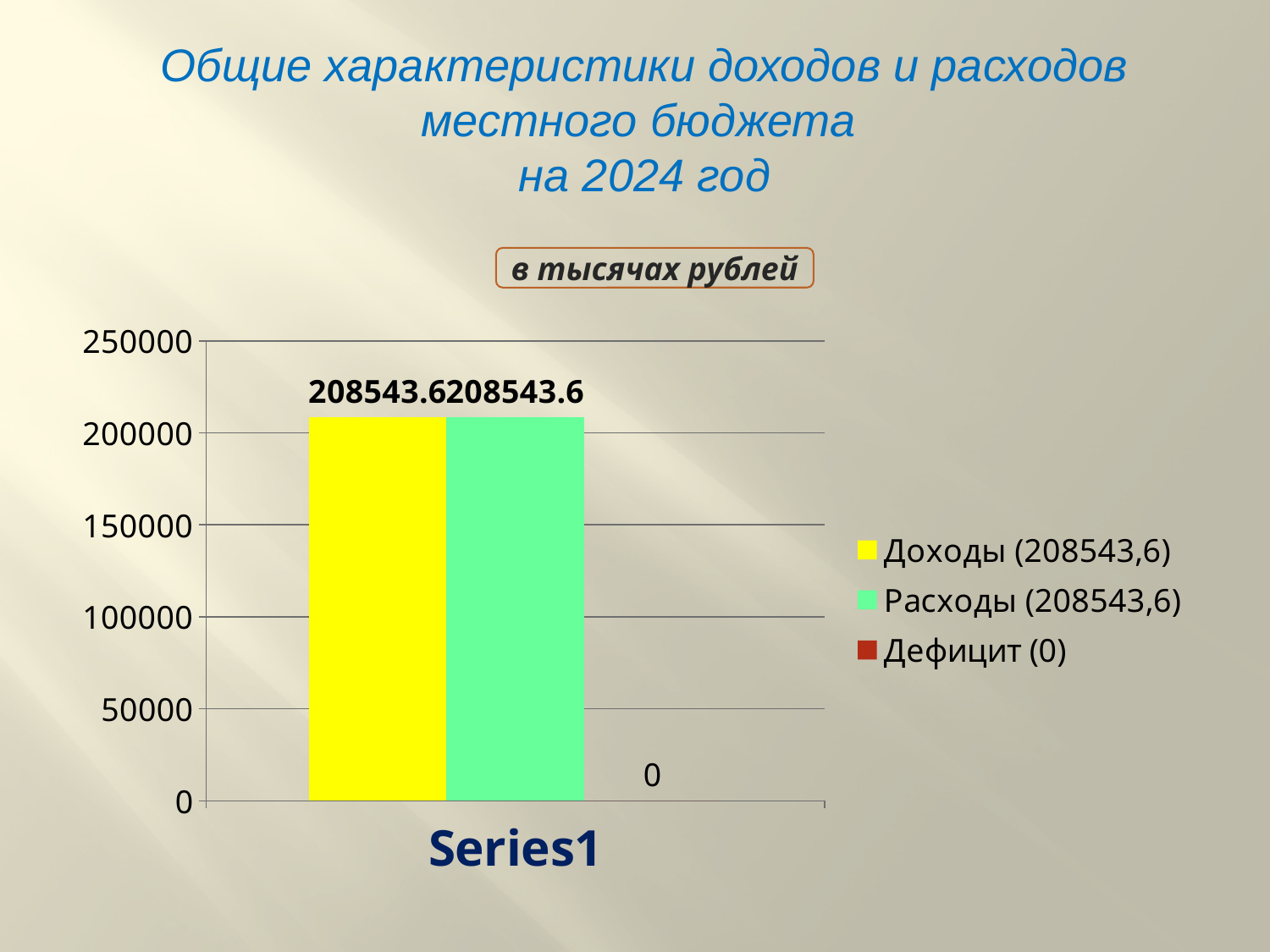
What is the difference between the Доходы and Расходы values? 0 What is the value of the Расходы bar? 208543.6 What is the value shown for Дефицит? 0 What is the difference between the Доходы value and the Дефицит value? 208543.6 What is the value of the Доходы bar? 208543.6 Is the value for Расходы greater or less than 250000? less Which series has the lowest value? Дефицит What colour is the Расходы series in the legend? green How many series does the legend list? 3 Is the value for Доходы greater or less than 200000? greater What kind of chart is shown on the slide? bar chart What is the category label shown on the x axis? Series1